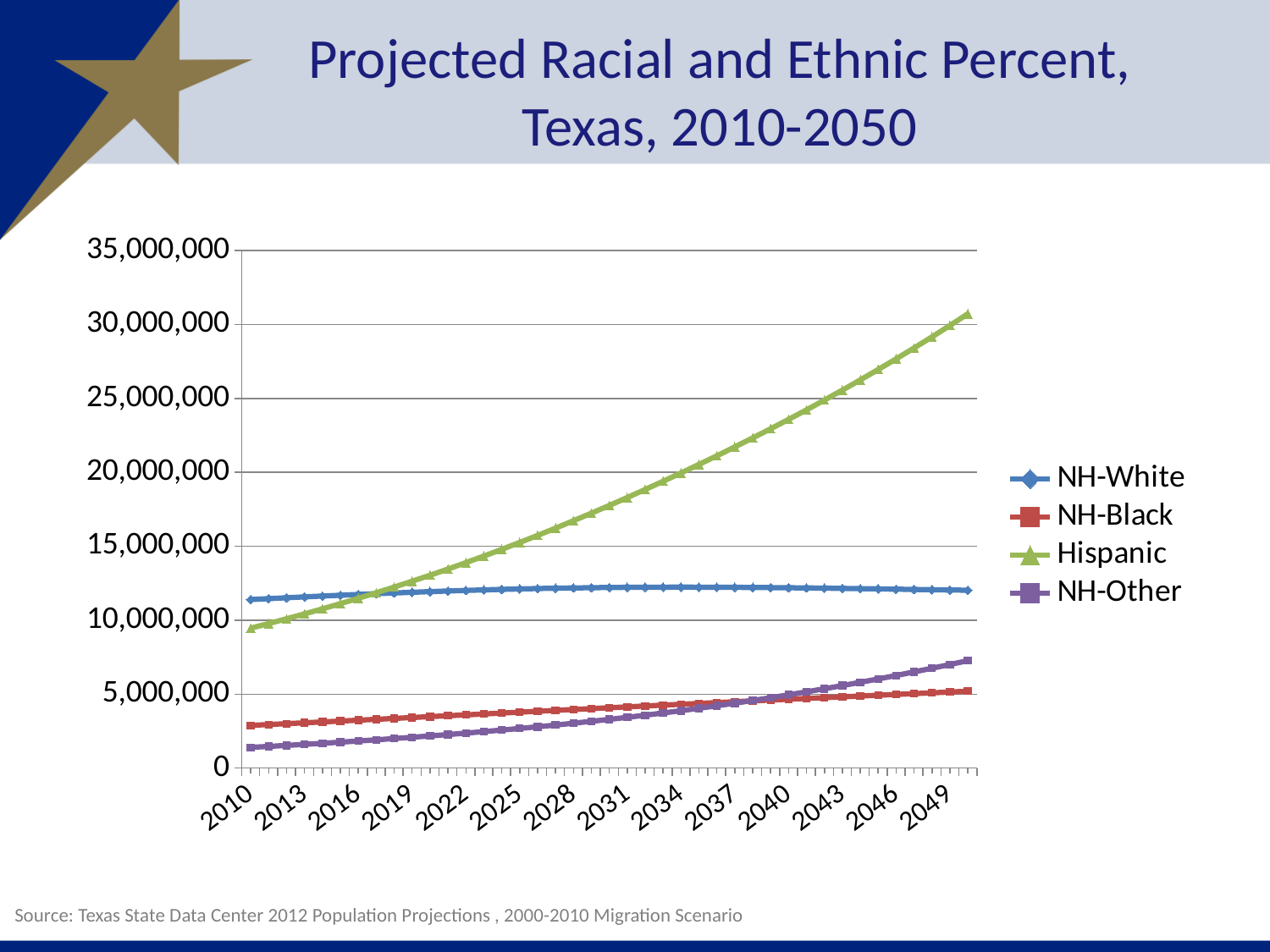
Does the Hispanic series rise or fall from 2010 to 2050? Rise What kind of chart is shown on the slide? Line chart In 2050, which is larger: NH-Other or NH-Black? NH-Other Which series has the highest value in 2010? NH-White In 2010, which is larger: NH-Black or NH-Other? NH-Black Which series has the highest value in 2050? Hispanic How many series does the legend list? 4 Which series has the lowest value in 2010? NH-Other Is the NH-Black value for 2050 greater or less than 10,000,000? less What is the title of the chart on the slide? Projected Racial and Ethnic Percent, Texas, 2010-2050 Is the NH-White value for 2010 greater or less than 10,000,000? greater Is the Hispanic value for 2040 greater or less than 20,000,000? greater